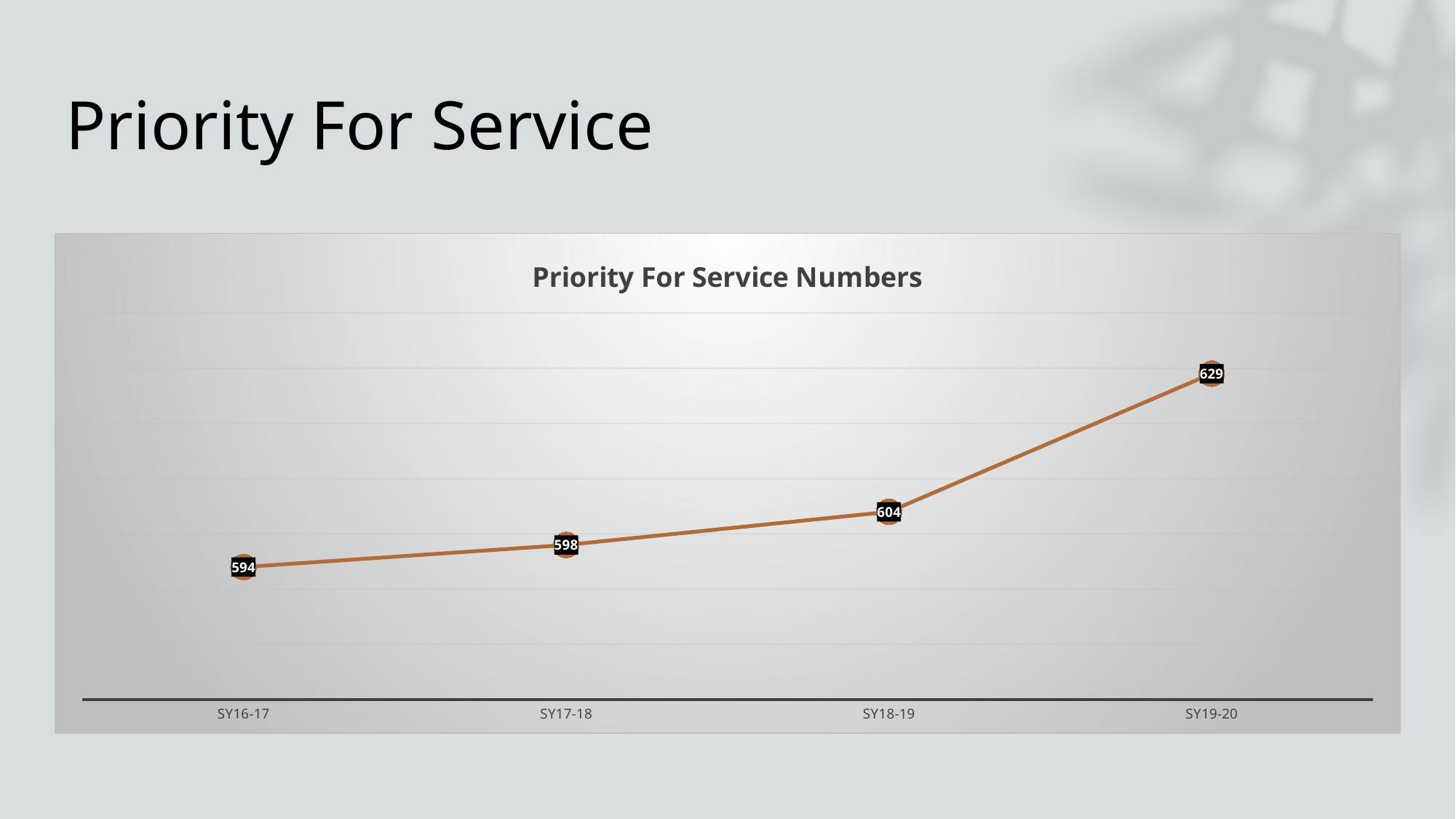
What is the Priority For Service number for SY19-20? 629 What kind of chart is shown on the slide? line chart What is the difference between the SY19-20 and SY18-19 values? 25 Which school year has the highest Priority For Service number? SY19-20 How many school years are plotted on the chart? 4 What is the Priority For Service number for SY18-19? 604 Which is larger, the value for SY18-19 or the value for SY17-18? SY18-19 What is the difference between the SY17-18 and SY16-17 values? 4 Do the values rise or fall from SY16-17 to SY19-20? rise What is the Priority For Service number for SY17-18? 598 What is the Priority For Service number for SY16-17? 594 Which school year has the lowest Priority For Service number? SY16-17